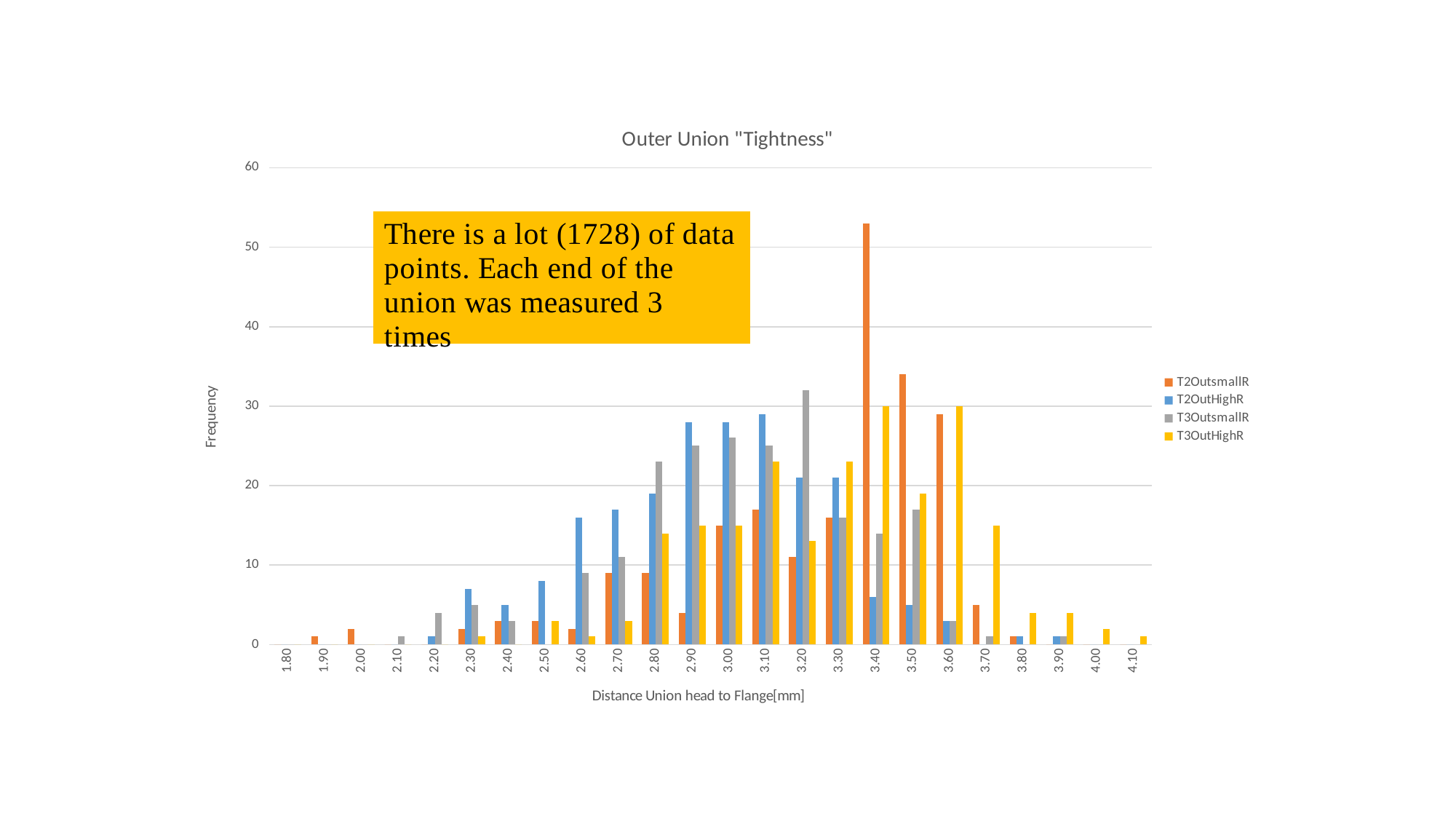
Is the value for T2OutsmallR at 3.40 greater or less than 50? greater Which series has the tallest bar in the chart? T2OutsmallR What is the label of the x axis? Distance Union head to Flange[mm] What kind of chart is shown on the slide? bar chart At 2.60, which is larger: T2OutHighR or T3OutsmallR? T2OutHighR Is the value for T3OutsmallR at 3.20 greater or less than 30? greater What is the title of the chart? Outer Union "Tightness" Is the value for T2OutHighR at 2.90 greater or less than 30? less At which x-axis category does the T2OutsmallR series reach its highest value? 3.40 At 3.40, which is larger: T2OutsmallR or T2OutHighR? T2OutsmallR How many categories are shown along the x axis? 24 How many series does the legend list? 4